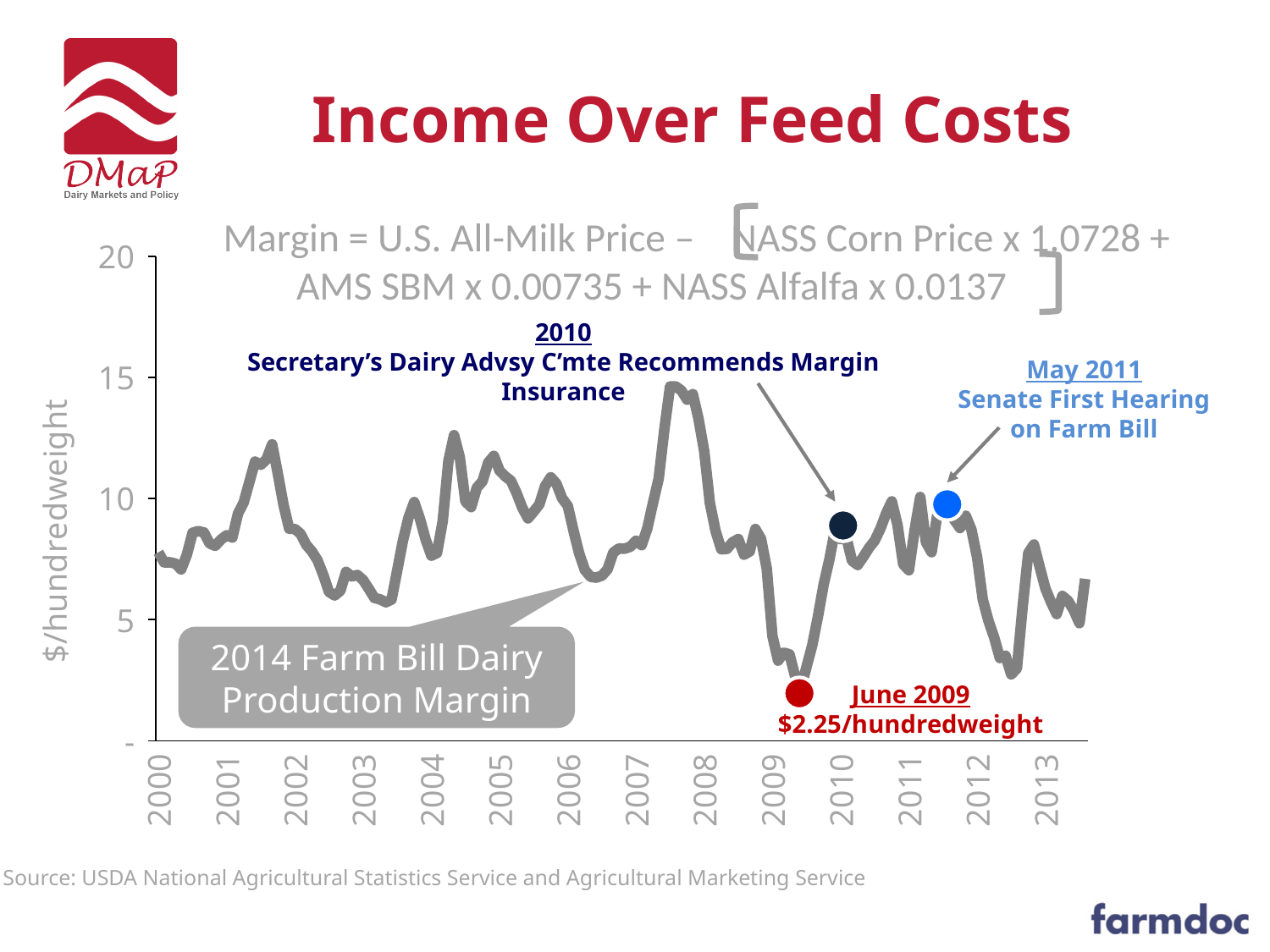
What is the title of the chart? Income Over Feed Costs What is the label on the y axis of the chart? $/hundredweight Is the value at the start of 2000 greater or less than 5? greater What kind of chart is shown on the slide? line chart Is the value for June 2009 greater or less than 5? less What margin value is labelled for June 2009? $2.25/hundredweight How many year labels are shown on the x axis? 14 Which is larger, the value at the 2010 marker or the value at the June 2009 marker? 2010 Is the peak value reached in 2004 greater or less than 10? greater Which is larger, the value at the June 2009 marker or the value at the May 2011 marker? May 2011 In which month and year does the chart reach its lowest value? June 2009